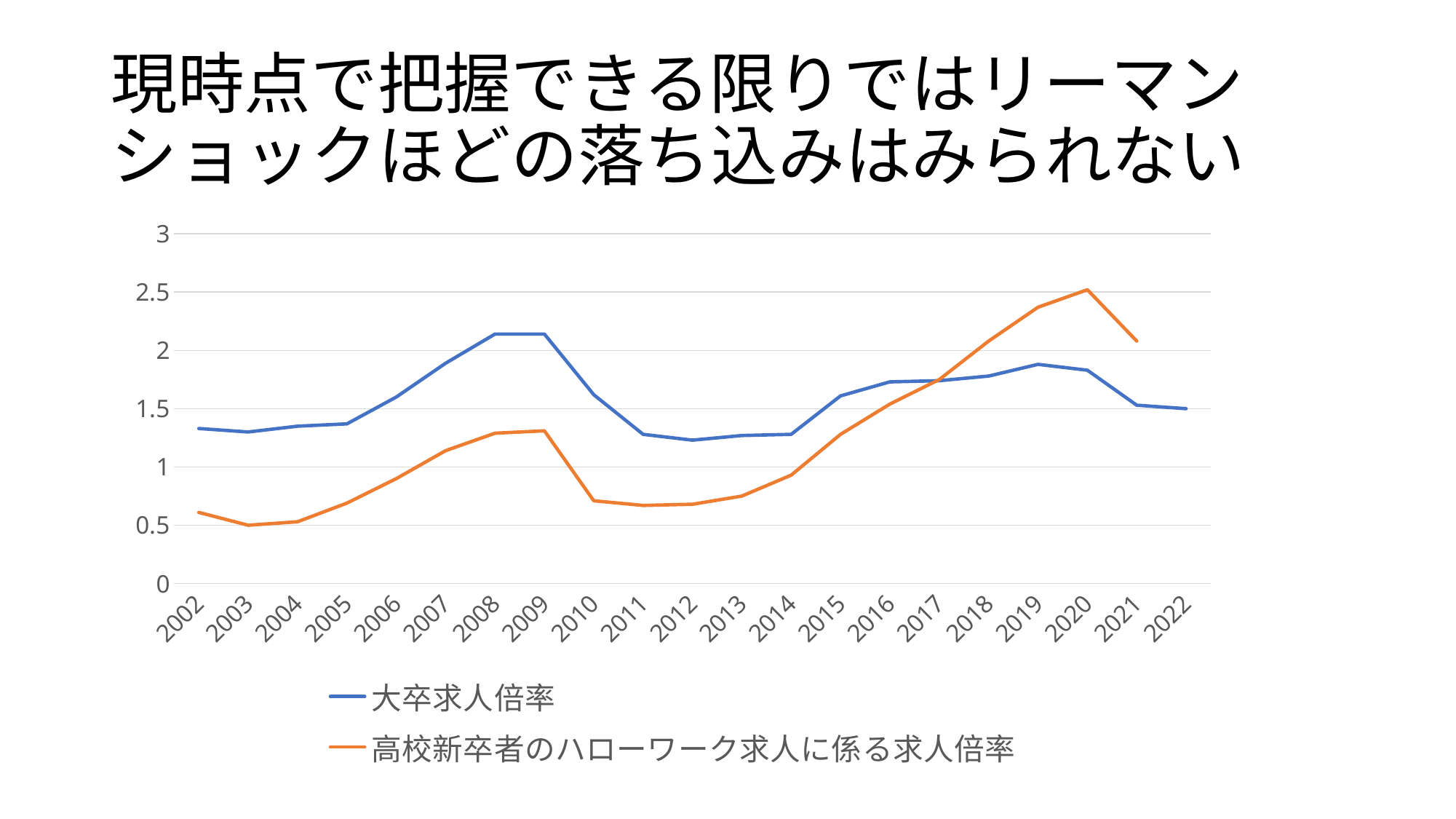
In which year does 高校新卒者のハローワーク求人に係る求人倍率 reach its highest value? 2020 What kind of chart is shown on the slide? line chart Is the value for 大卒求人倍率 in 2008 greater or less than 2? greater In 2020, which series has the larger value, 大卒求人倍率 or 高校新卒者のハローワーク求人に係る求人倍率? 高校新卒者のハローワーク求人に係る求人倍率 Which series reaches the highest value on the chart? 高校新卒者のハローワーク求人に係る求人倍率 Is the value for 大卒求人倍率 in 2019 greater or less than 2? less Which colour is used for the 大卒求人倍率 line? blue How many series does the legend list? 2 In 2008, which series has the larger value, 大卒求人倍率 or 高校新卒者のハローワーク求人に係る求人倍率? 大卒求人倍率 Does 高校新卒者のハローワーク求人に係る求人倍率 rise or fall from 2014 to 2020? rise How many years are shown on the x axis? 21 Is the value for 高校新卒者のハローワーク求人に係る求人倍率 in 2010 greater or less than 1? less